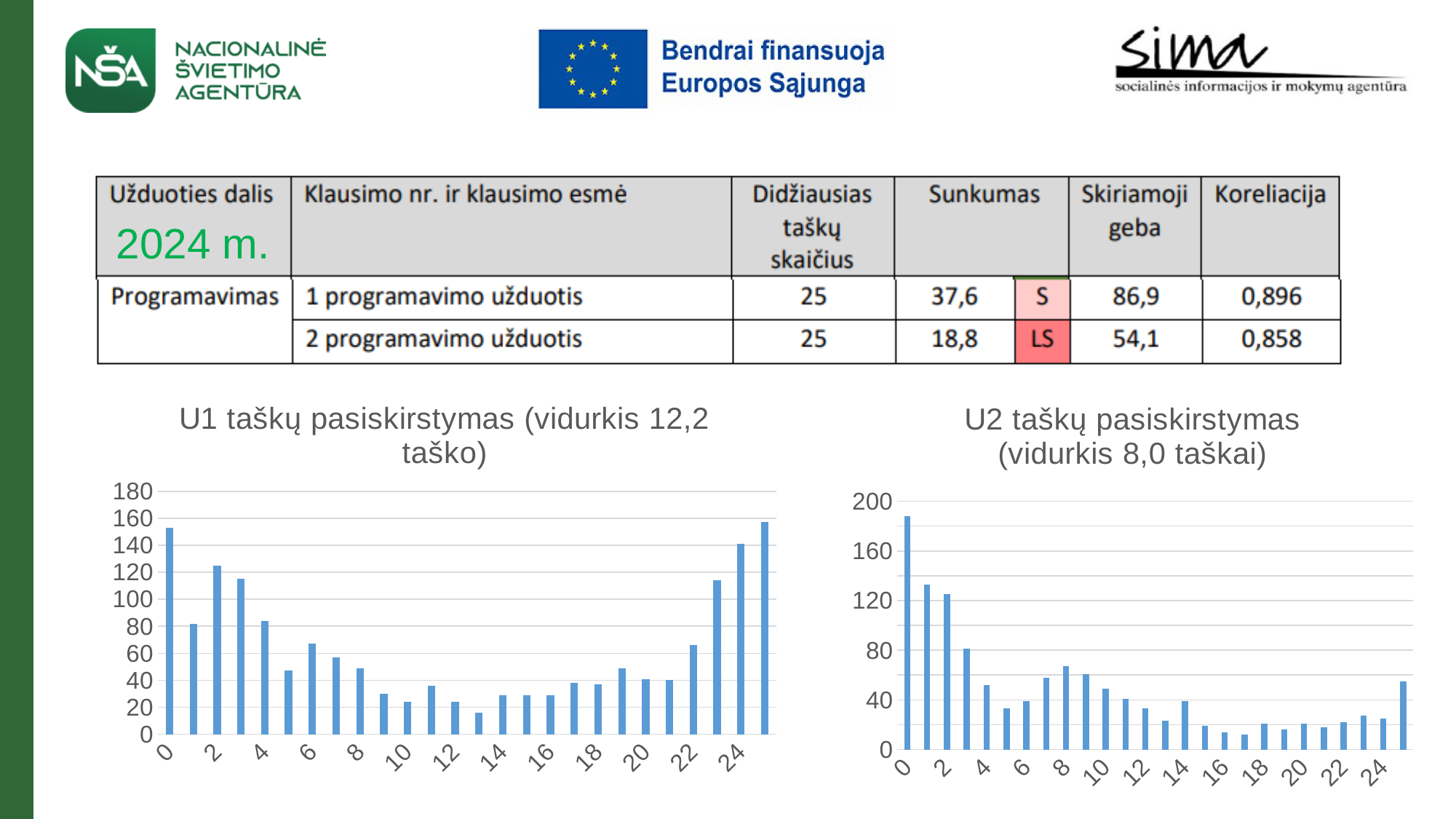
In the U1 taškų pasiskirstymas chart, is the value for score 0 greater or less than 140? greater In the U1 taškų pasiskirstymas chart, which score has the highest number of students? 25 In the U1 taškų pasiskirstymas chart, which is larger, the value for score 2 or the value for score 4? score 2 What kind of chart is the U1 taškų pasiskirstymas chart? bar chart What average score is stated in the title of the U2 taškų pasiskirstymas chart? 8,0 taškai In the U1 taškų pasiskirstymas chart, which score has the lowest bar? 13 How many bars does the U2 taškų pasiskirstymas chart show? 26 In the U2 taškų pasiskirstymas chart, which is larger, the value for score 8 or the value for score 12? score 8 In the U1 taškų pasiskirstymas chart, is the value for score 10 greater or less than 40? less In the U2 taškų pasiskirstymas chart, which score has the highest bar? 0 In the U2 taškų pasiskirstymas chart, is the value for score 0 greater or less than 160? greater